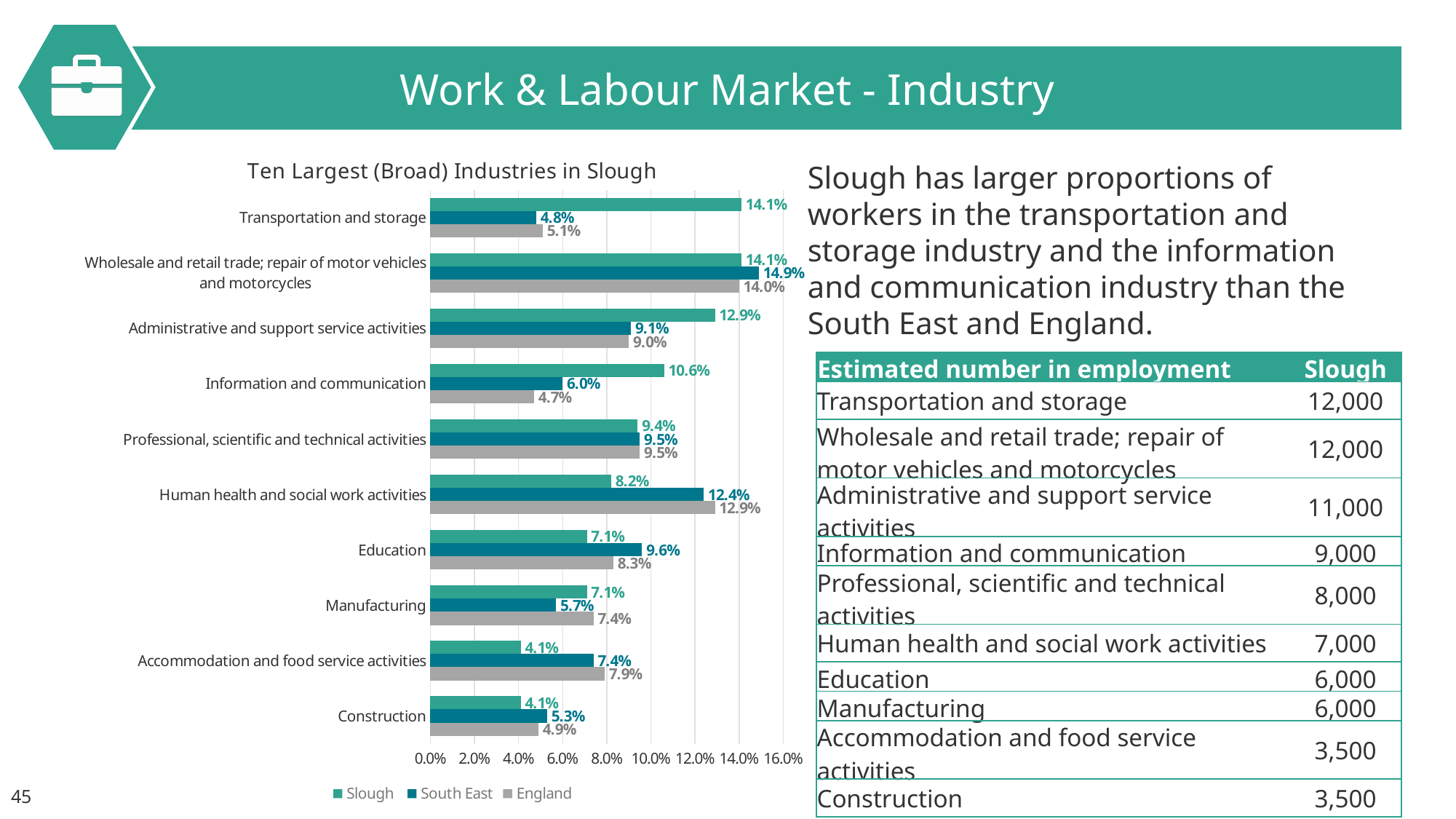
For Accommodation and food service activities, which is larger: the Slough value or the South East value? South East What is the South East value for Education? 9.6% What is the difference between the Slough and South East values for Transportation and storage? 9.3 percentage points What is the Slough value for Transportation and storage? 14.1% Which industry has the lowest England value? Information and communication Which industry has the highest South East value? Wholesale and retail trade; repair of motor vehicles and motorcycles How many industries are shown in the chart? 10 What kind of chart is shown on the slide? Bar chart What is the England value for Human health and social work activities? 12.9% What is the title of the chart? Ten Largest (Broad) Industries in Slough How many series does the legend list? 3 For Information and communication, which is larger: the Slough value or the England value? Slough